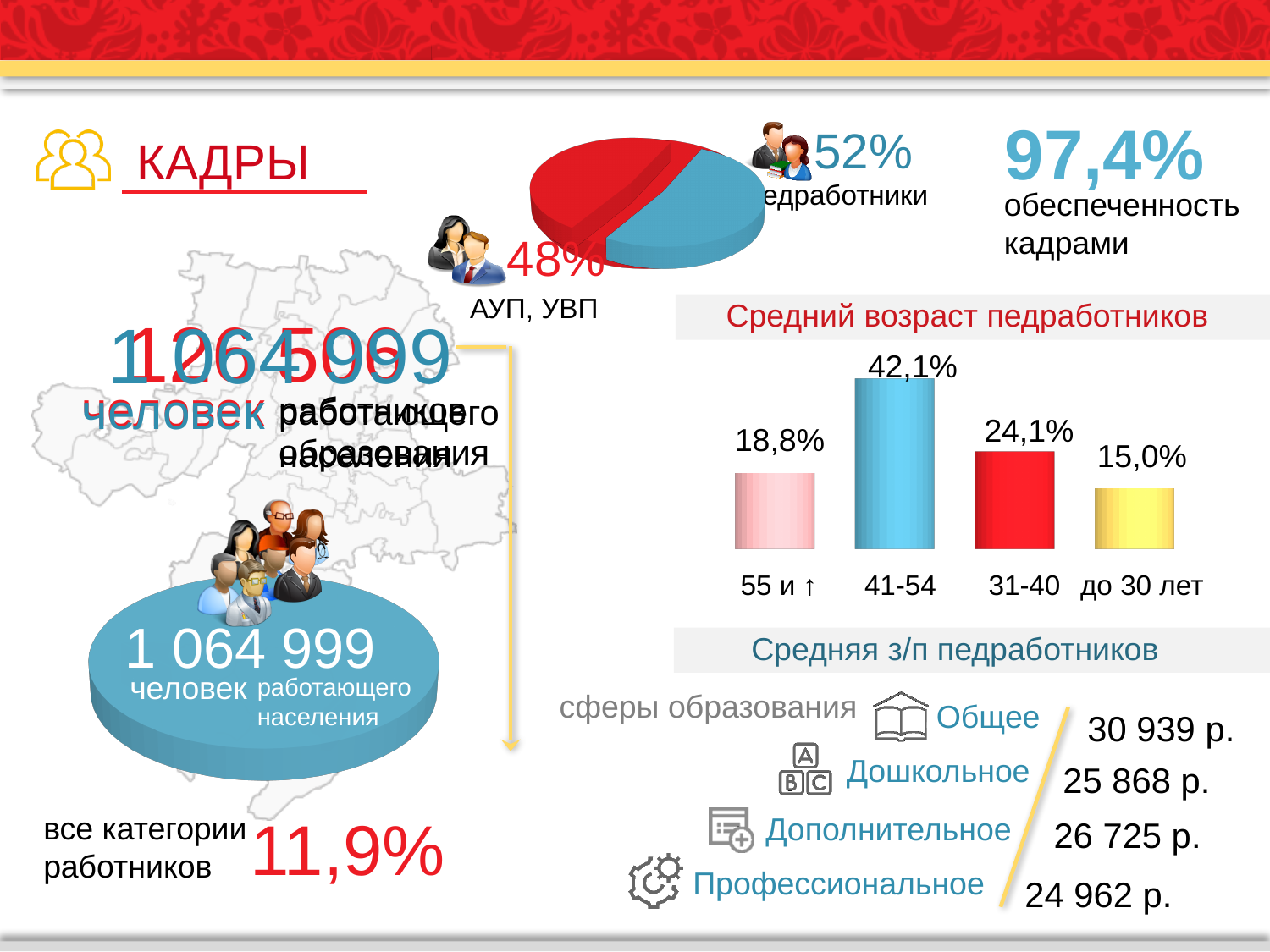
In the bar chart titled "Средний возраст педработников", what is the value for the 41-54 age group? 42,1% In the bar chart titled "Средний возраст педработников", which is larger: the value for 31-40 or for "55 и ↑"? 31-40 In the pie chart at the top centre of the slide, what share is labelled "педработники"? 52% How many age groups are shown in the bar chart titled "Средний возраст педработников"? 4 In the bar chart titled "Средний возраст педработников", which age group has the highest value? 41-54 In the pie chart at the top centre of the slide, what share is labelled "АУП, УВП"? 48% In the bar chart titled "Средний возраст педработников", what is the difference between the 41-54 and 31-40 values? 18,0% In the bar chart titled "Средний возраст педработников", what is the value for the "до 30 лет" age group? 15,0% What kind of chart is "Средний возраст педработников"? bar chart In the bar chart titled "Средний возраст педработников", what is the value for the 31-40 age group? 24,1% In the bar chart titled "Средний возраст педработников", which age group has the lowest value? до 30 лет In the bar chart titled "Средний возраст педработников", what is the value for the "55 и ↑" age group? 18,8%